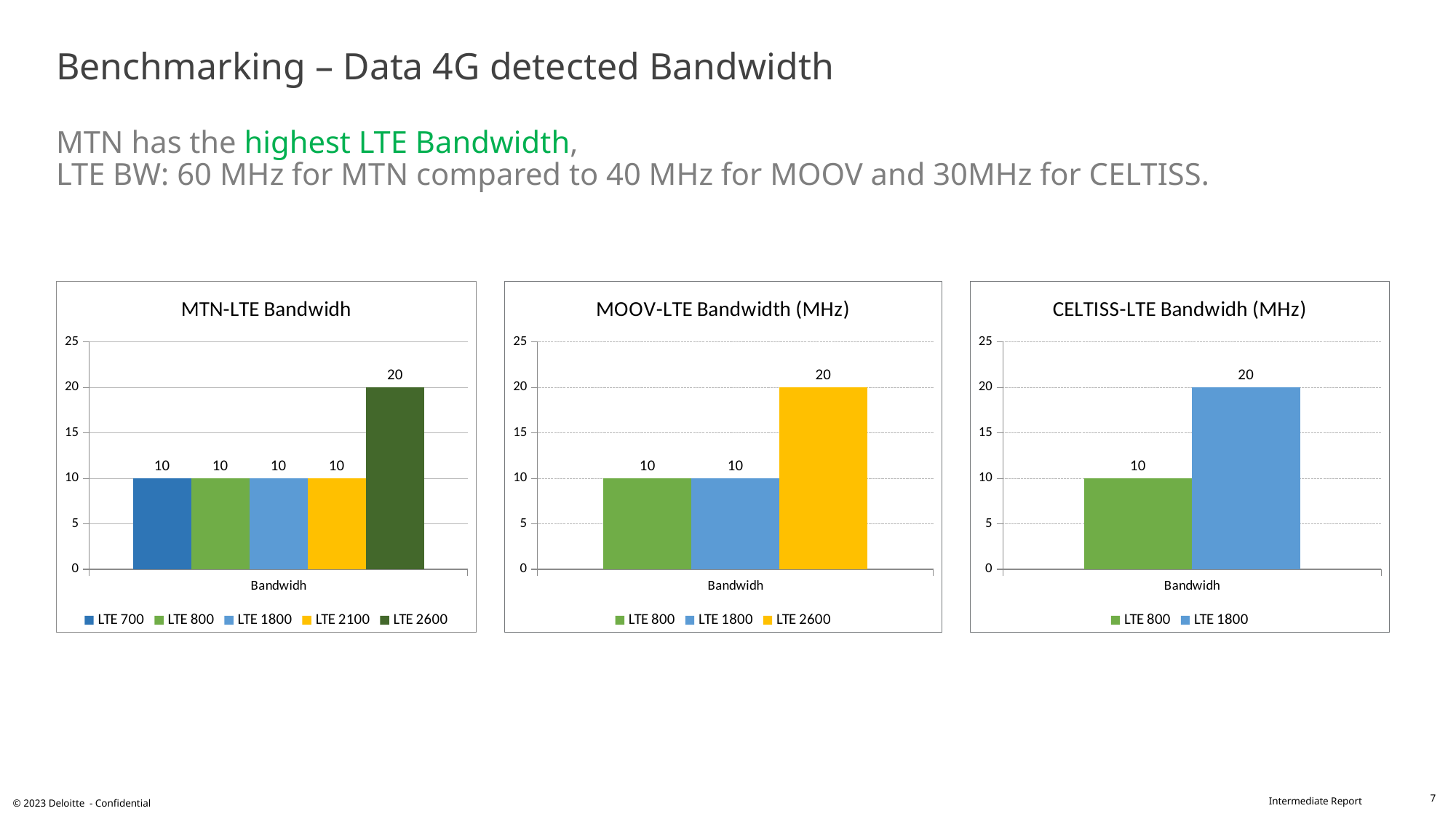
How many series does the legend of the CELTISS-LTE Bandwidh (MHz) chart list? 2 In the CELTISS-LTE Bandwidh (MHz) chart, which series has the highest value? LTE 1800 In the MOOV-LTE Bandwidth (MHz) chart, which series has the highest value? LTE 2600 In the MTN-LTE Bandwidh chart, what is the difference between the LTE 2600 value and the LTE 2100 value? 10 How many series does the legend of the MTN-LTE Bandwidh chart list? 5 In the MTN-LTE Bandwidh chart, what is the value for LTE 700? 10 In the CELTISS-LTE Bandwidh (MHz) chart, what is the value for LTE 800? 10 In the MTN-LTE Bandwidh chart, what is the value for LTE 2600? 20 In the MTN-LTE Bandwidh chart, what colour is the LTE 2100 bar? Yellow What kind of chart is the MOOV-LTE Bandwidth (MHz) chart? Bar chart In the MOOV-LTE Bandwidth (MHz) chart, what is the value for LTE 2600? 20 In the MOOV-LTE Bandwidth (MHz) chart, which is larger, the value for LTE 800 or the value for LTE 2600? LTE 2600